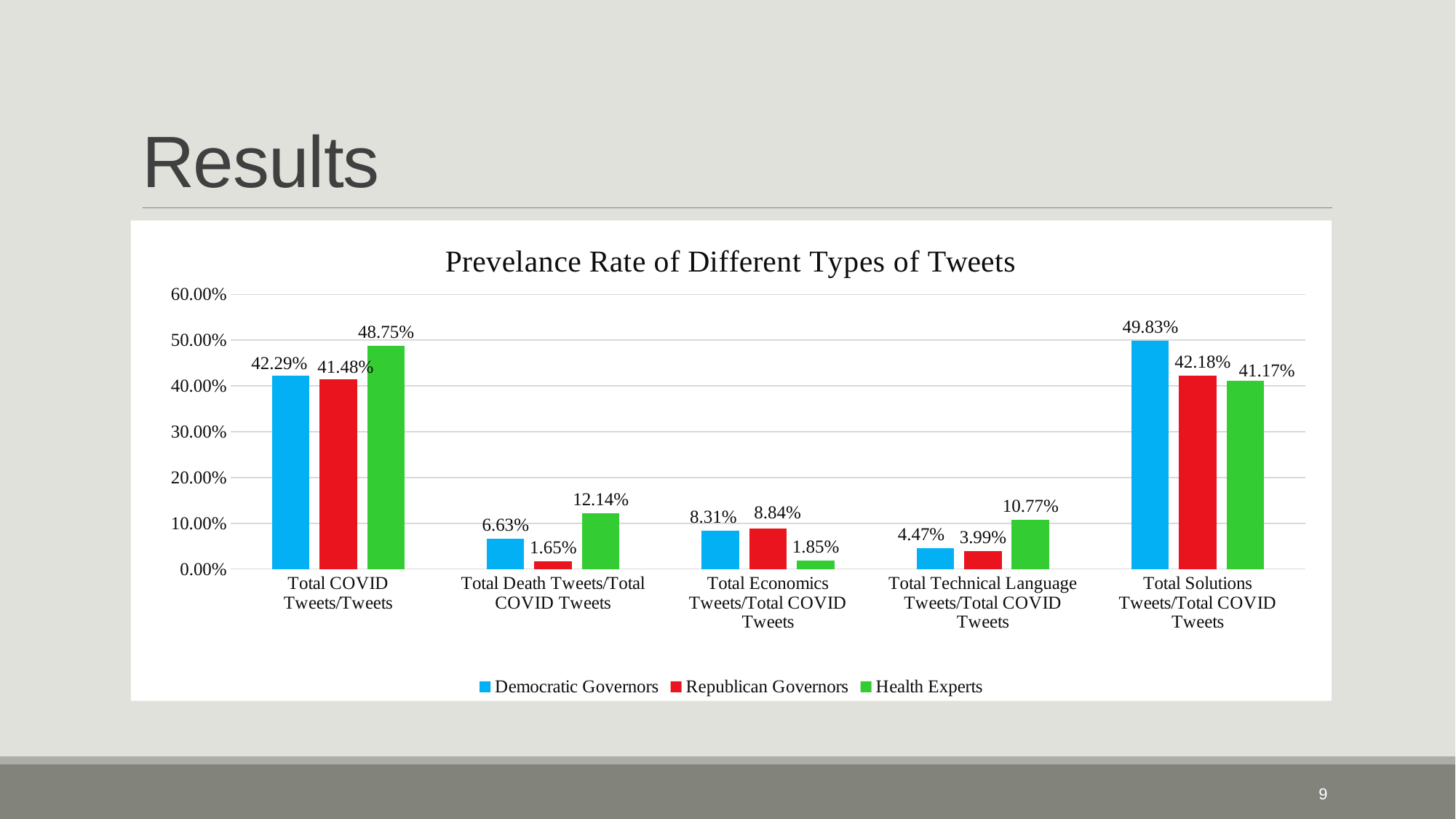
What kind of chart is shown on the slide? Bar chart What is the value for Health Experts in the Total Death Tweets/Total COVID Tweets category? 12.14% How many categories are shown on the x axis? 5 How many series does the legend list? 3 Which series has the highest value in the Total Solutions Tweets/Total COVID Tweets category? Democratic Governors What is the difference between the Health Experts and Democratic Governors values in the Total Technical Language Tweets/Total COVID Tweets category? 6.30% Is the Democratic Governors value for Total Solutions Tweets/Total COVID Tweets greater or less than 40.00%? greater What is the value for Democratic Governors in the Total COVID Tweets/Tweets category? 42.29% Which is larger: the Health Experts value for Total COVID Tweets/Tweets or the Health Experts value for Total Solutions Tweets/Total COVID Tweets? Total COVID Tweets/Tweets What is the value for Republican Governors in the Total Economics Tweets/Total COVID Tweets category? 8.84% Which series has the lowest value in the Total Death Tweets/Total COVID Tweets category? Republican Governors What is the title of the chart? Prevelance Rate of Different Types of Tweets